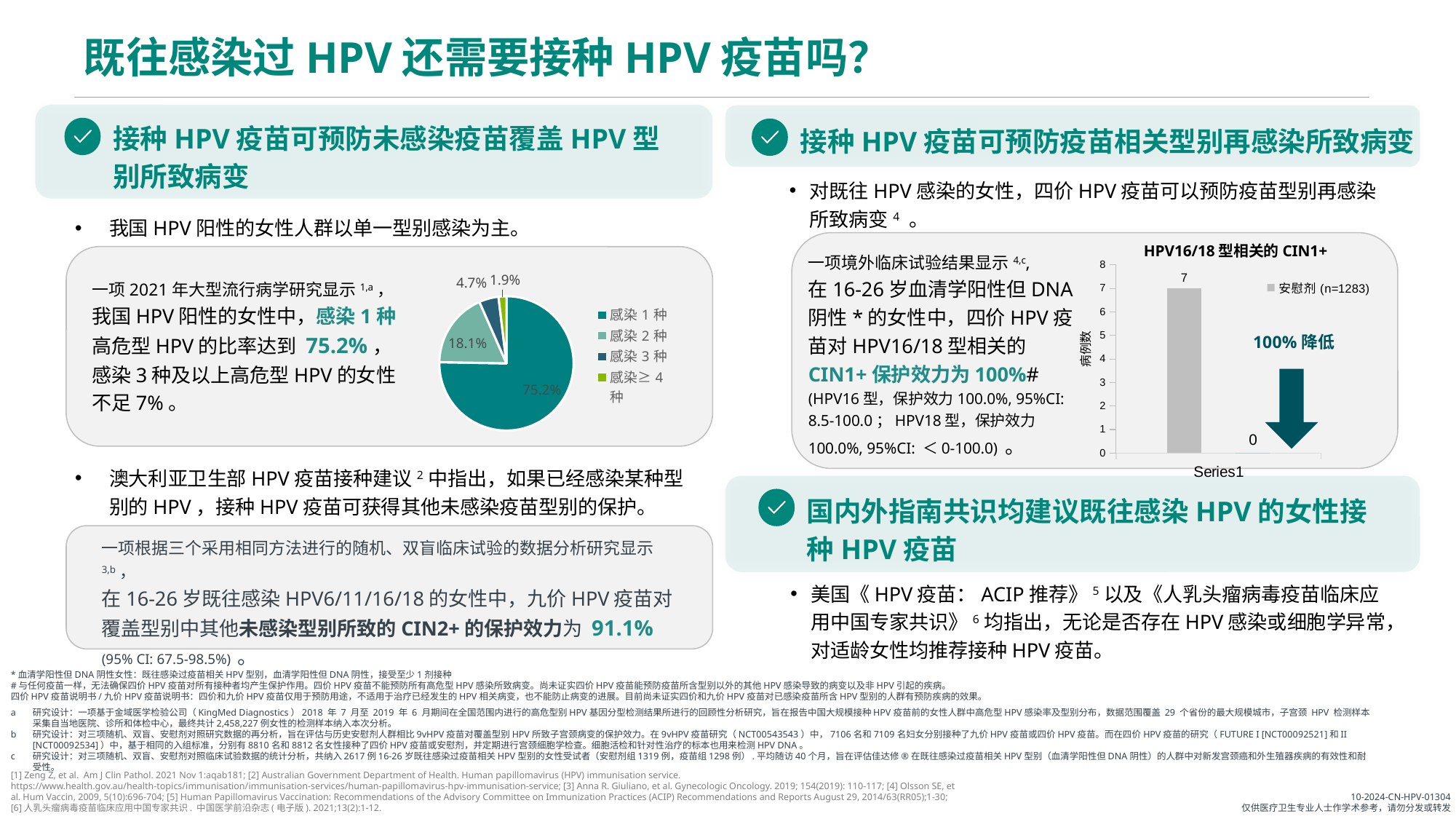
What type of chart is the chart titled 'HPV16/18 型相关的 CIN1+'? Bar chart In the pie chart on the left, what is the difference between the 感染 1 种 and 感染 2 种 shares? 57.1% In the pie chart on the left, what is the value for 感染 2 种? 18.1% In the pie chart on the left, what is the value for 感染≥ 4 种? 1.9% In the chart titled 'HPV16/18 型相关的 CIN1+', what is the y-axis label? 病例数 In the pie chart on the left, what is the value for 感染 3 种? 4.7% In the pie chart on the left, which category has the smallest slice? 感染≥ 4 种 In the chart titled 'HPV16/18 型相关的 CIN1+', what is the value of the 安慰剂 (n=1283) bar? 7 What type of chart is the chart on the left? Pie chart In the pie chart on the left, which category has the largest slice? 感染 1 种 In the pie chart on the left, what share of HPV-positive women are infected with 1 type (感染 1 种)? 75.2% How many categories does the pie chart on the left show? 4